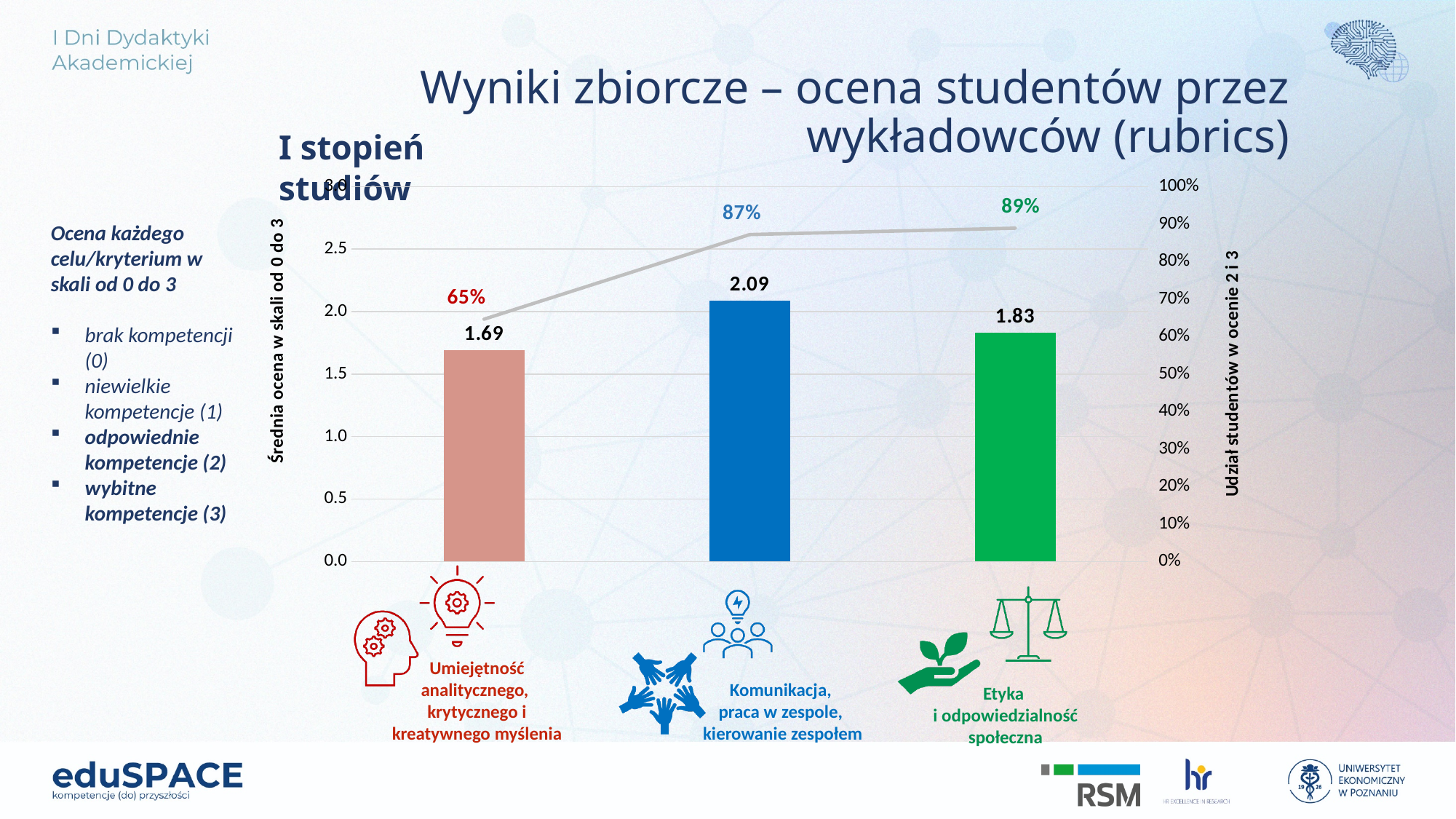
Which has a higher average score: 'Etyka i odpowiedzialność społeczna' or 'Umiejętność analitycznego, krytycznego i kreatywnego myślenia'? Etyka i odpowiedzialność społeczna What percentage of students scored 2 or 3 (Udział studentów w ocenie 2 i 3) for 'Etyka i odpowiedzialność społeczna'? 89% Which category has the highest average score? Komunikacja, praca w zespole, kierowanie zespołem What is the label of the right-hand vertical axis? Udział studentów w ocenie 2 i 3 How many categories (bars) are shown in the chart? 3 What is the average score (Średnia ocena) for 'Komunikacja, praca w zespole, kierowanie zespołem'? 2.09 What is the difference between the average scores for 'Komunikacja, praca w zespole, kierowanie zespołem' and 'Etyka i odpowiedzialność społeczna'? 0.26 What percentage is shown for 'Umiejętność analitycznego, krytycznego i kreatywnego myślenia'? 65% What is the difference in percentage points between the 87% for 'Komunikacja' and the 65% for 'Umiejętność analitycznego'? 22 percentage points What kind of chart is used to show the average scores? bar chart Which category has the lowest average score? Umiejętność analitycznego, krytycznego i kreatywnego myślenia What is the average score for 'Umiejętność analitycznego, krytycznego i kreatywnego myślenia'? 1.69